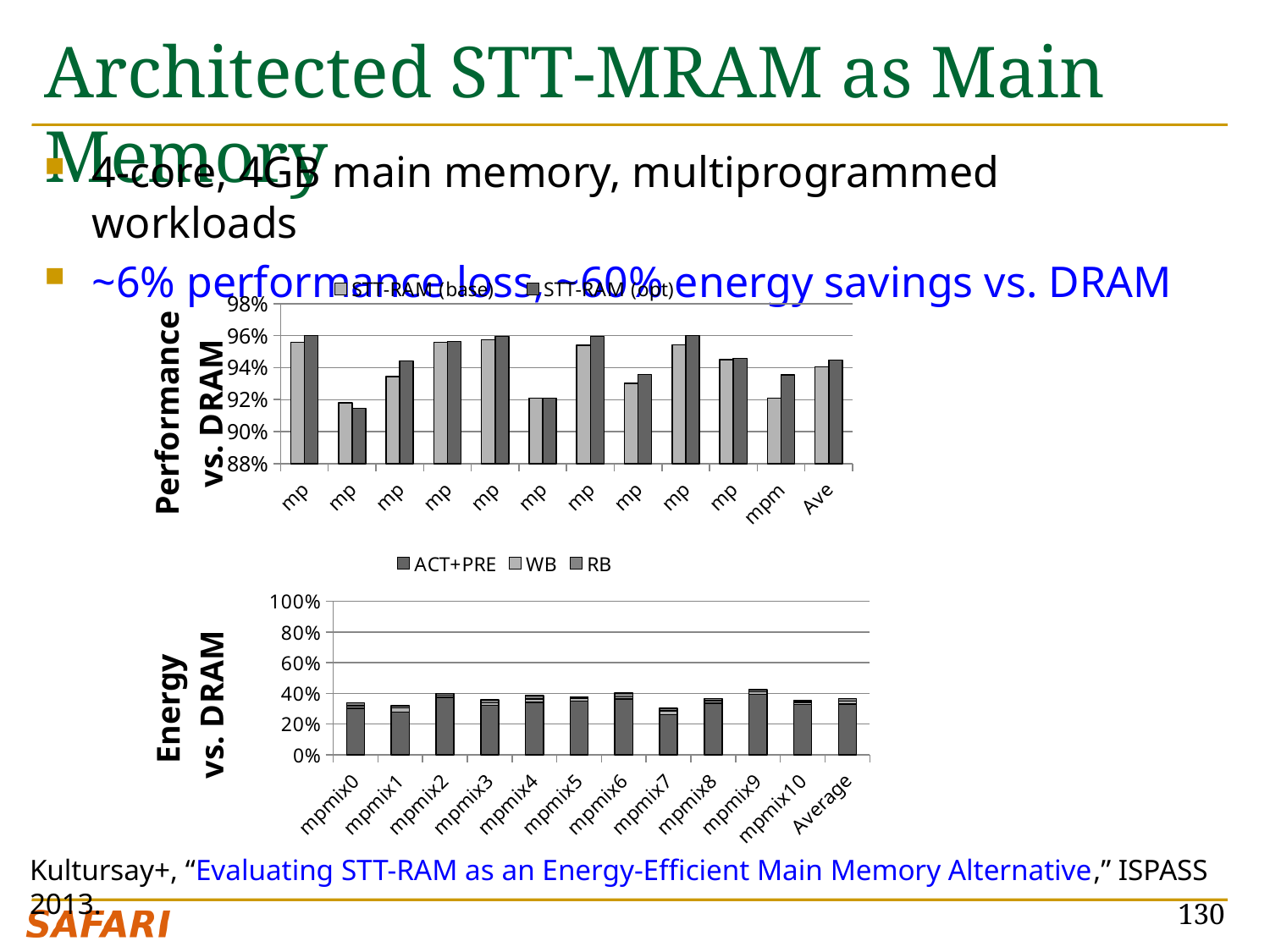
What type of chart is the 'Performance vs. DRAM' chart at the top of the slide? Bar chart How many series does the legend of the 'Energy vs. DRAM' chart list? 3 In the 'Performance vs. DRAM' chart, is the STT-RAM (opt) value for Ave greater or less than 92%? greater In the 'Energy vs. DRAM' chart, which series makes up the largest part of each stacked bar? ACT+PRE How many series does the legend of the 'Performance vs. DRAM' chart list? 2 In the 'Energy vs. DRAM' chart, is the total for mpmix0 greater or less than 60%? less How many categories are shown on the x axis of the 'Energy vs. DRAM' chart? 12 What type of chart is the 'Energy vs. DRAM' chart at the bottom of the slide? Stacked bar chart In the 'Energy vs. DRAM' chart, is the total for Average greater or less than 40%? less What are the names of the two series in the legend of the 'Performance vs. DRAM' chart? STT-RAM (base) and STT-RAM (opt) In the 'Energy vs. DRAM' chart, which category has the lowest total bar? mpmix7